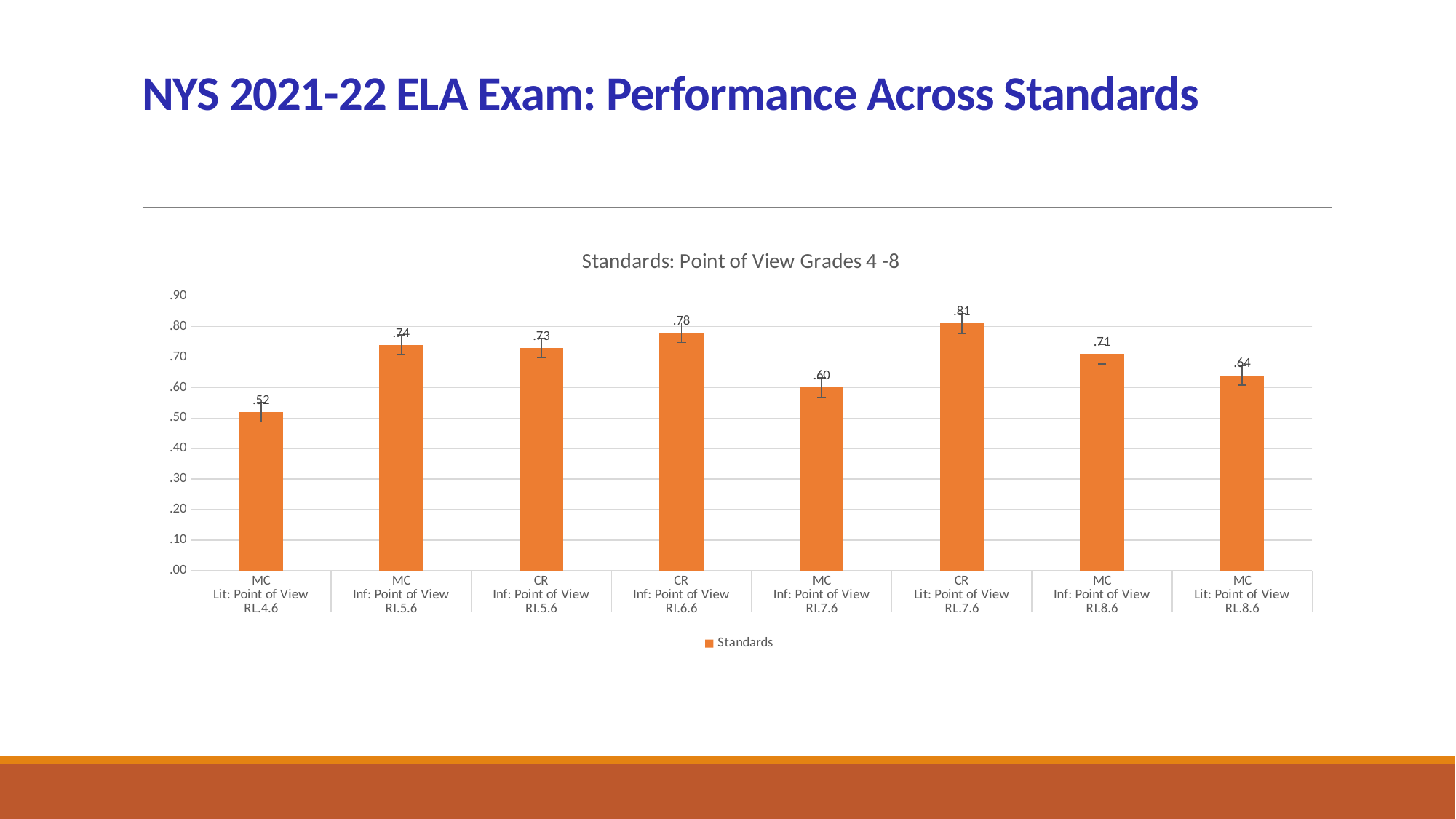
What is the value for MC Lit: Point of View RL.4.6? .52 Which is larger, the value for CR Inf: Point of View RI.6.6 or the value for MC Inf: Point of View RI.8.6? CR Inf: Point of View RI.6.6 Which category has the lowest value? MC Lit: Point of View RL.4.6 What is the difference between the values for CR Lit: Point of View RL.7.6 and MC Lit: Point of View RL.4.6? .29 What is the value for MC Inf: Point of View RI.7.6? .60 How many series does the legend list? 1 What is the title of the chart? Standards: Point of View Grades 4 -8 What is the value for MC Lit: Point of View RL.8.6? .64 How many categories are shown on the chart? 8 Which category has the highest value? CR Lit: Point of View RL.7.6 What is the value for CR Lit: Point of View RL.7.6? .81 What kind of chart is shown on the slide? Bar chart